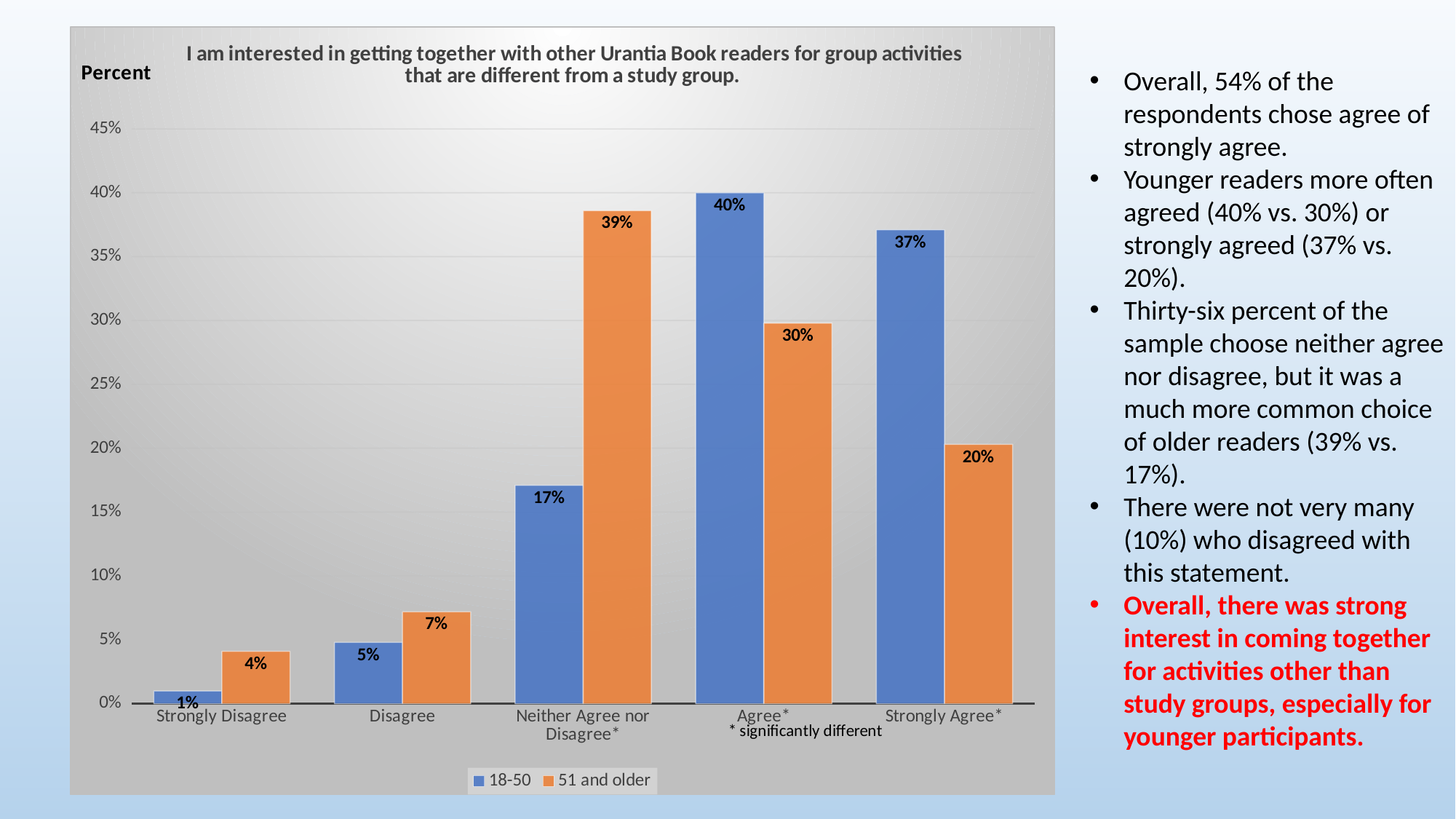
Which response category has the highest value for the 18-50 group? Agree Is the value for 18-50 respondents who chose Strongly Agree greater or less than 35%? greater What percentage of 18-50 respondents chose Agree? 40% How many series does the legend list? 2 What percentage of respondents aged 51 and older chose Neither Agree nor Disagree? 39% What kind of chart is shown on the slide? Bar chart Which colour represents the 51 and older group in the chart? Orange How many response categories are shown on the x axis? 5 For Neither Agree nor Disagree, which group has the larger value, 18-50 or 51 and older? 51 and older What is the difference between the 18-50 and 51 and older values for Strongly Agree? 17% Which response category has the lowest value for the 51 and older group? Strongly Disagree What percentage of respondents aged 51 and older chose Strongly Agree? 20%